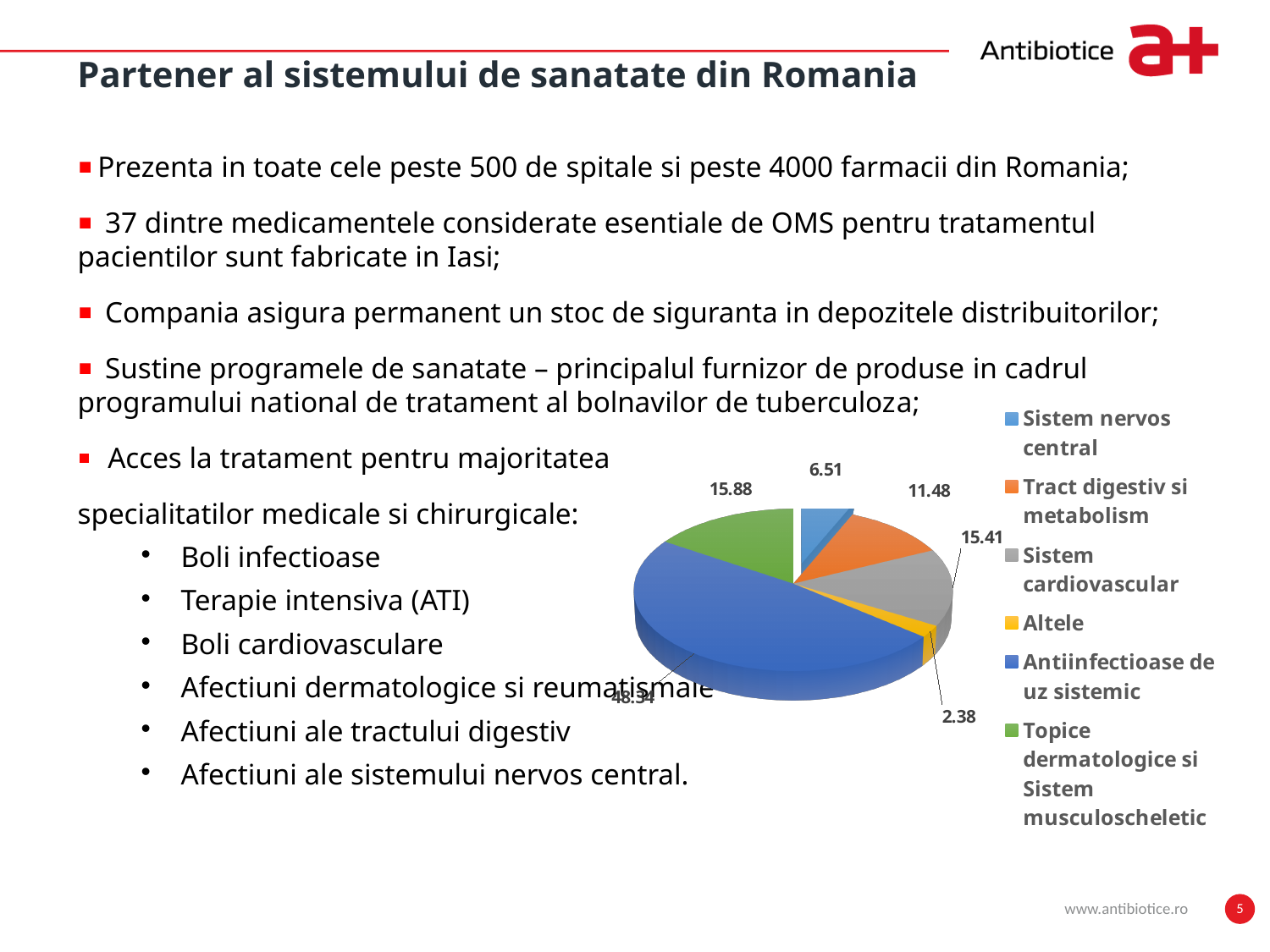
What is the value for Topice dermatologice si Sistem musculoscheletic in the pie chart? 15.88 What type of chart is shown on the slide? pie chart What is the value for Tract digestiv si metabolism in the pie chart? 11.48 Which category has the largest slice in the pie chart? Antiinfectioase de uz sistemic What is the value for Sistem cardiovascular in the pie chart? 15.41 Which is larger in the pie chart: Tract digestiv si metabolism or Sistem nervos central? Tract digestiv si metabolism Which category has the smallest slice in the pie chart? Altele What is the value for Altele in the pie chart? 2.38 How many slices does the pie chart have? 6 What is the value for Sistem nervos central in the pie chart? 6.51 What is the difference between the values for Sistem cardiovascular and Tract digestiv si metabolism? 3.93 What colour is the Altele slice in the pie chart? yellow